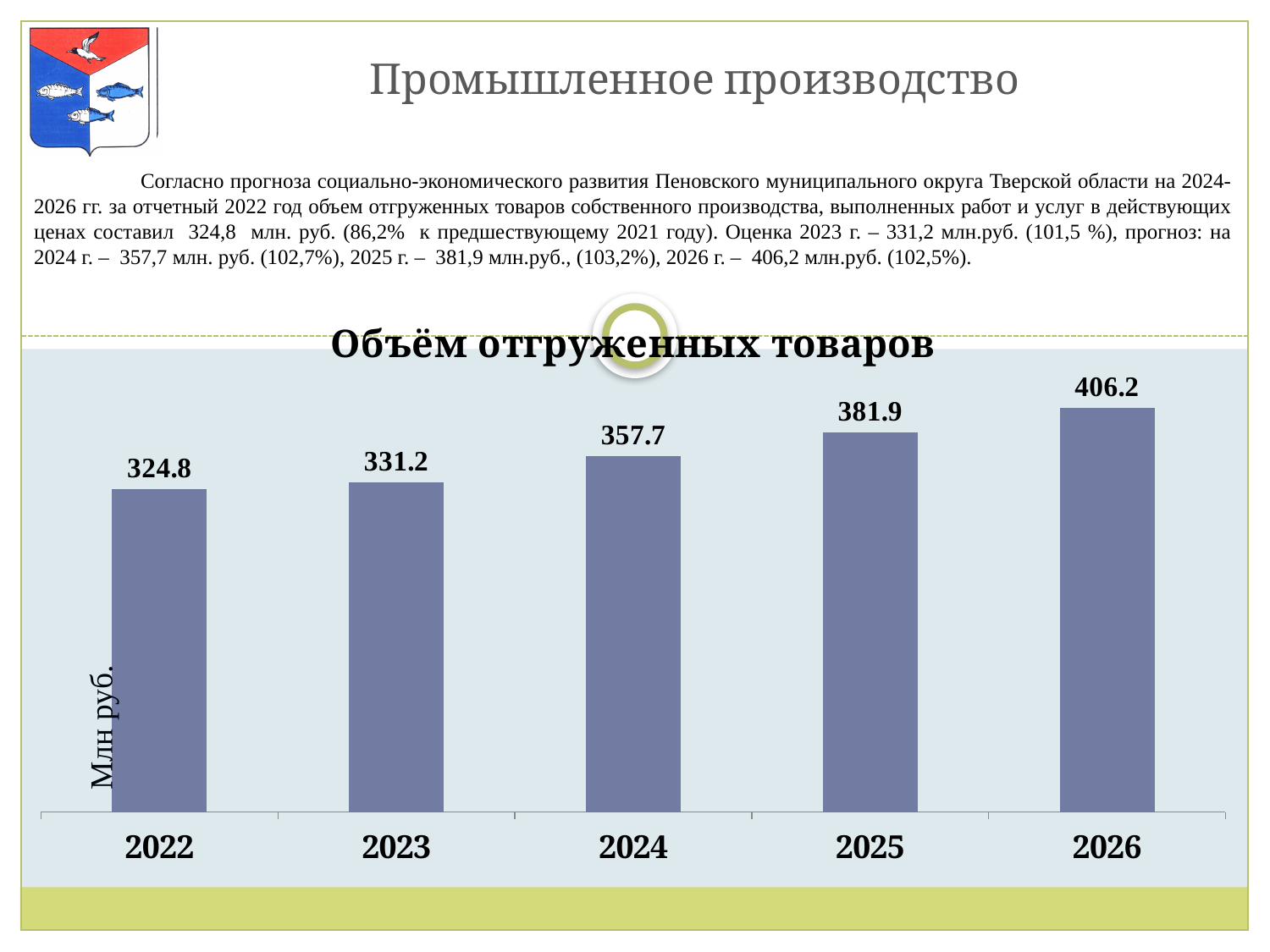
What is the value for 2022 in the chart? 324.8 Which is larger, the value for 2023 or the value for 2025? 2025 Which year has the lowest value in the chart? 2022 What is the title of the chart? Объём отгруженных товаров What is the difference between the values for 2026 and 2022? 81.4 Do the values rise or fall from 2022 to 2026? rise Which year has the highest value in the chart? 2026 What is the value for 2024 in the chart? 357.7 What is the value for 2026 in the chart? 406.2 What is the difference between the values for 2025 and 2024? 24.2 What kind of chart is shown on the slide? bar chart How many years are shown on the x axis of the chart? 5